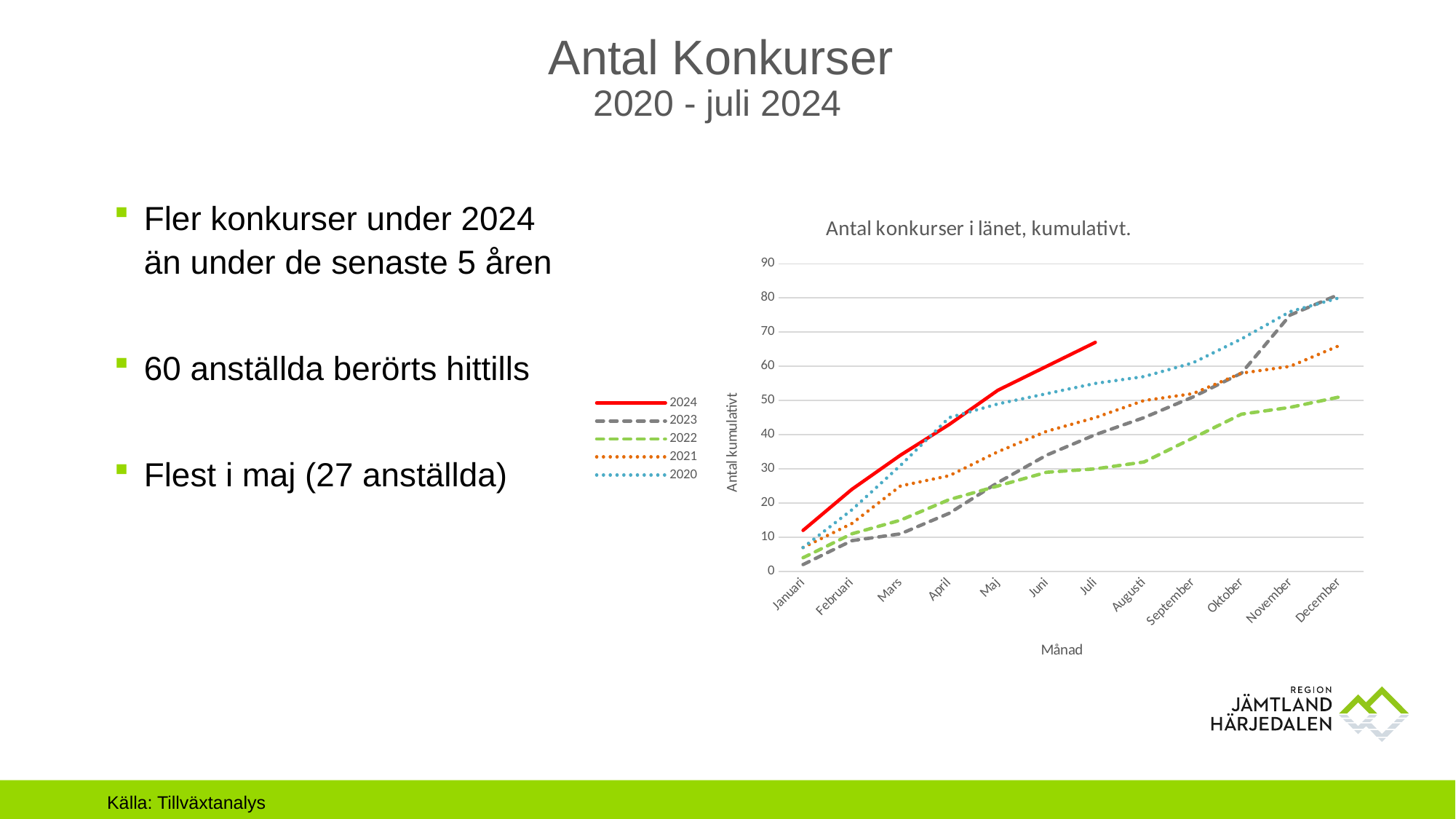
How many months are shown along the x axis of the chart? 12 Is the value for 2024 in Juli greater or less than 60? greater How many series does the legend of the chart list? 5 Do the values of the 2024 series rise or fall from Januari to Juli? rise What kind of chart is shown on the slide? line chart What is the title of the chart? Antal konkurser i länet, kumulativt. Is the value for 2021 in December greater or less than 60? greater Which series has the highest value in Juli? 2024 Is the value for 2023 in Januari greater or less than 10? less What is the label of the y axis of the chart? Antal kumulativt Which series has the lowest value in December? 2022